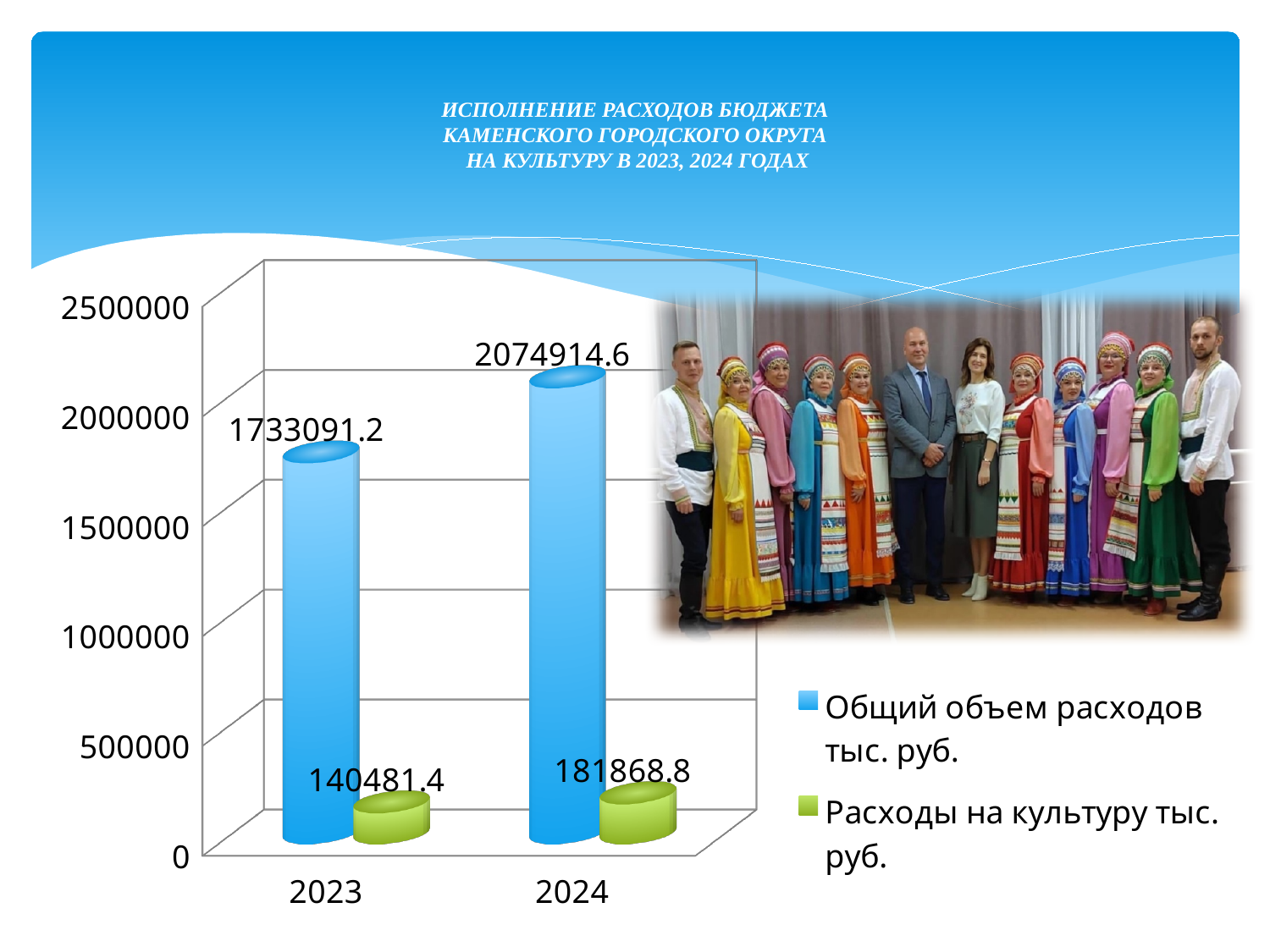
How many series does the chart legend list? 2 Which year has the higher value for "Расходы на культуру тыс. руб."? 2024 By how much did "Общий объем расходов тыс. руб." increase from 2023 to 2024? 341823.4 Is the value of "Общий объем расходов тыс. руб." for 2024 greater or less than 2000000? greater What is the value of "Общий объем расходов тыс. руб." for 2023? 1733091.2 What is the value of "Расходы на культуру тыс. руб." for 2023? 140481.4 What is the difference between "Расходы на культуру тыс. руб." in 2024 and in 2023? 41387.4 What is the value of "Расходы на культуру тыс. руб." for 2024? 181868.8 How many years (categories) are shown on the x axis of the chart? 2 Does "Общий объем расходов тыс. руб." rise or fall from 2023 to 2024? Rise What kind of chart is shown on the slide? Bar chart What is the value of "Общий объем расходов тыс. руб." for 2024? 2074914.6